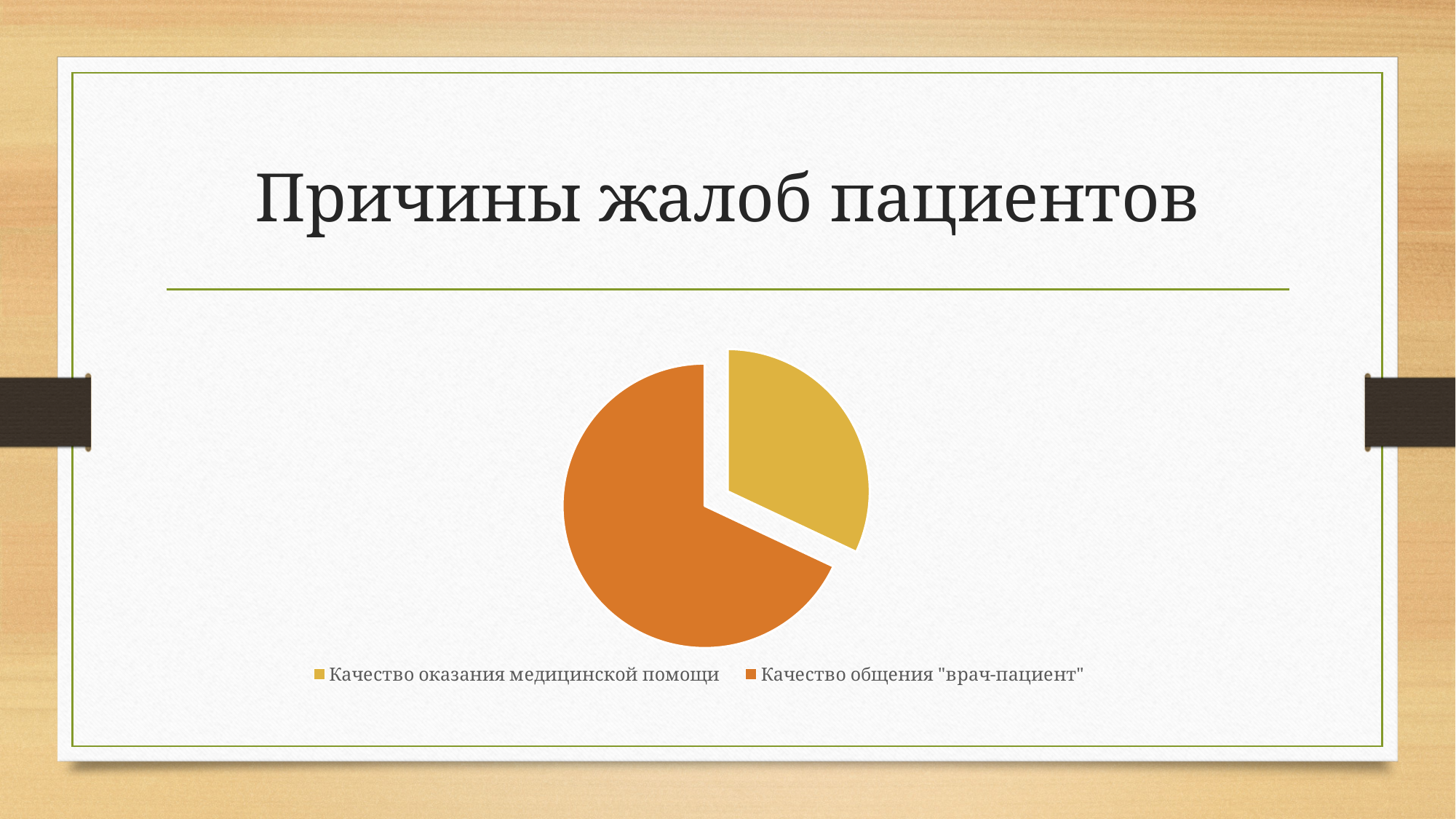
What kind of chart is shown on the slide? pie chart How many entries does the legend of the pie chart list? 2 Which category has the largest slice of the pie chart? Качество общения "врач-пациент" What colour is the slice for "Качество оказания медицинской помощи" in the pie chart? yellow What is the title of the slide containing the pie chart? Причины жалоб пациентов How many slices does the pie chart have? 2 Which slice is larger: "Качество оказания медицинской помощи" or "Качество общения "врач-пациент""? Качество общения "врач-пациент" Which category has the smallest slice of the pie chart? Качество оказания медицинской помощи